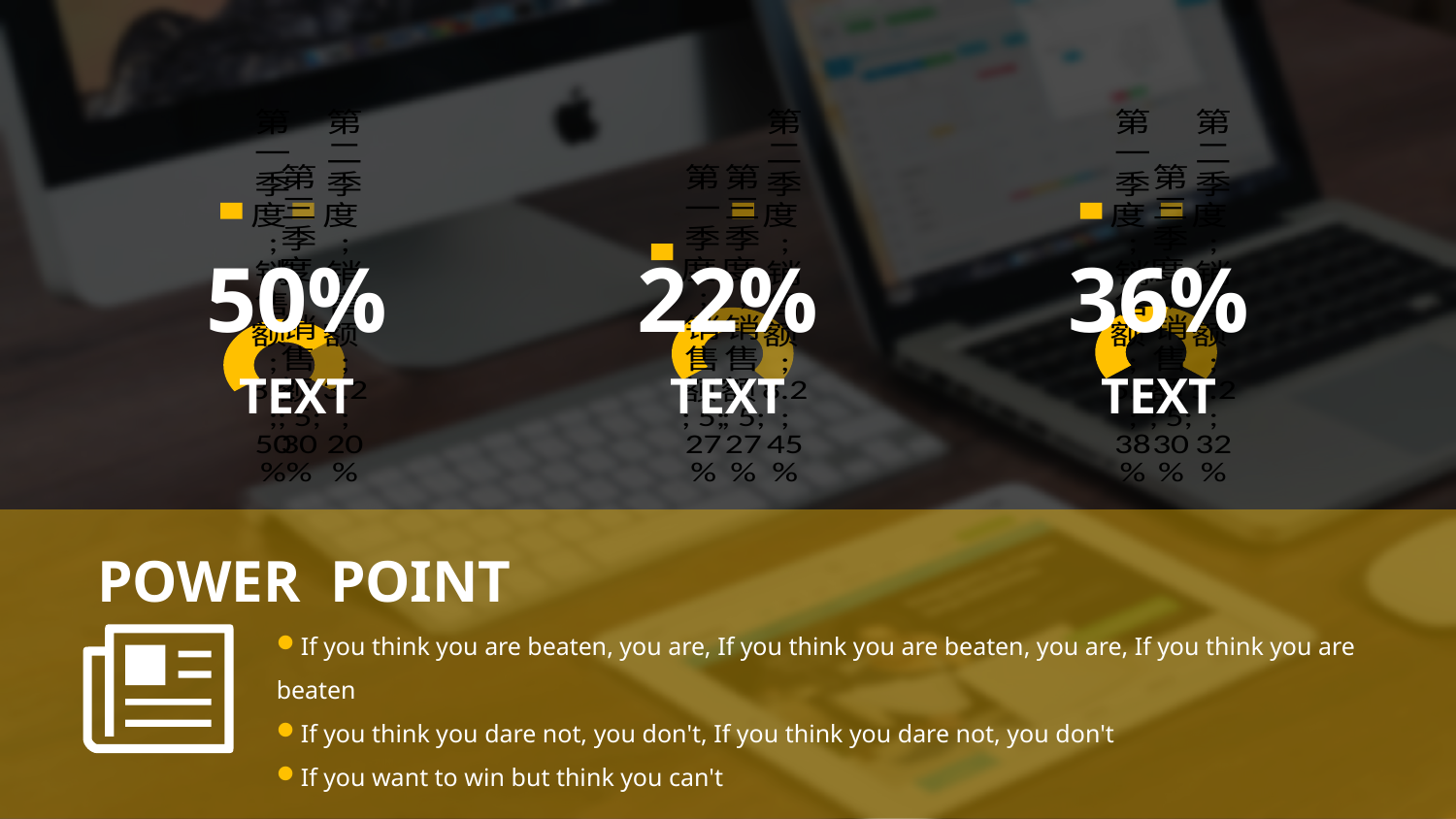
What large percentage is overlaid on the left doughnut chart? 50% In the right doughnut chart, what is the smallest slice value shown? 30% What kind of chart is shown on the left of the slide? Doughnut (pie) chart In the left doughnut chart, how many slices are there? 3 How many doughnut charts are on the slide? 3 In the left doughnut chart, what is the smallest slice value shown? 20% In the middle doughnut chart, what is the largest slice value shown? 45% What large percentage is overlaid on the middle doughnut chart? 22% In the right doughnut chart, what is the largest slice value shown? 38% In the left doughnut chart, what is the largest slice value shown? 50%